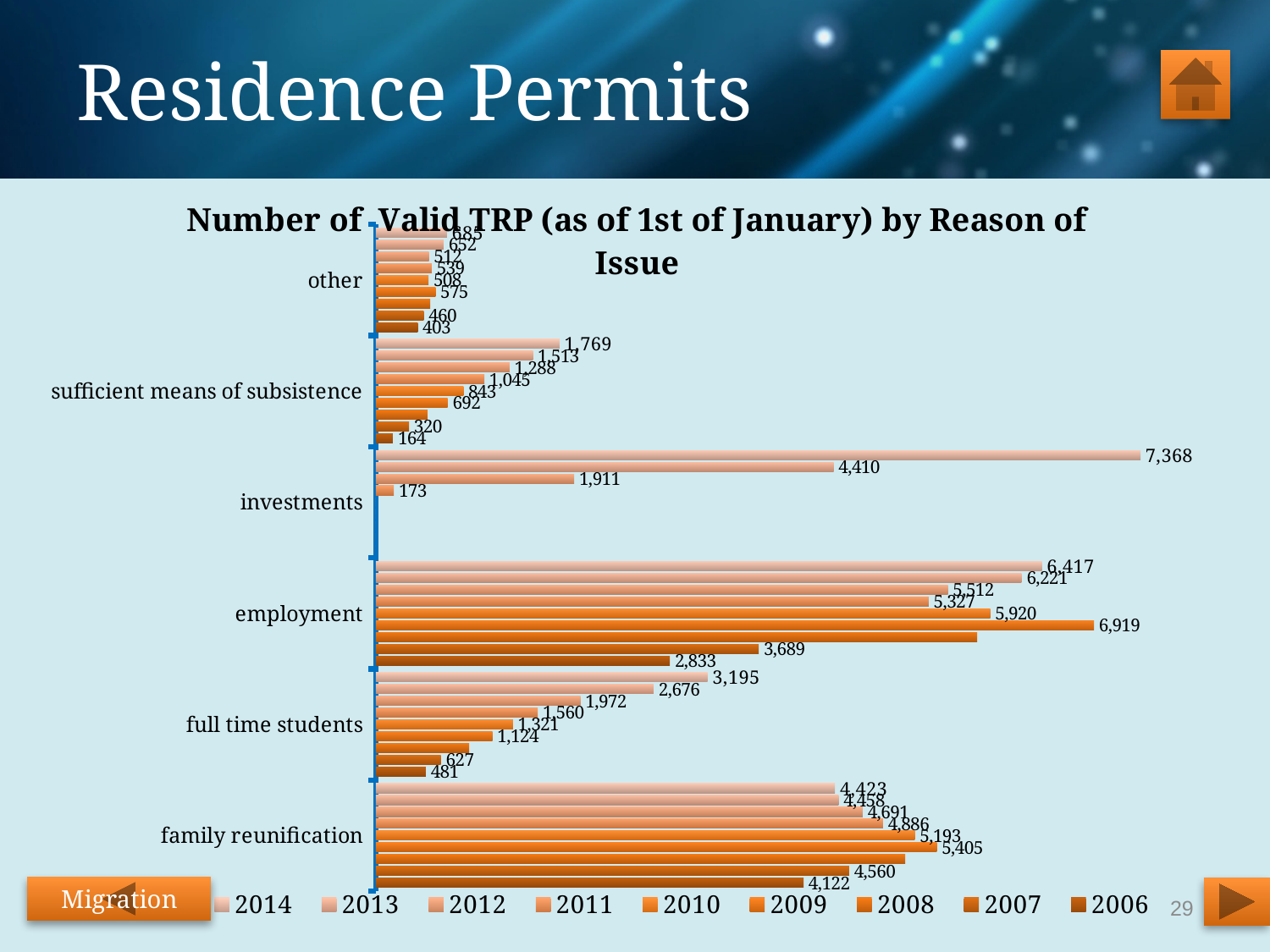
Do the values for full time students rise or fall from 2006 to 2014? rise What is the difference between the investments values for 2014 and 2013? 2,958 What is the number of valid TRP for family reunification in 2014? 4,423 How many reason-of-issue categories are shown on the chart? 6 What is the title of the chart? Number of Valid TRP (as of 1st of January) by Reason of Issue What kind of chart is shown on the slide? bar chart What is the number of valid TRP for sufficient means of subsistence in 2014? 1,769 What is the number of valid TRP for employment in 2006? 2,833 Which category has the highest value in 2014? investments What is the number of valid TRP for investments in 2014? 7,368 Which is larger in 2014: employment or family reunification? employment How many series (years) does the legend list? 9